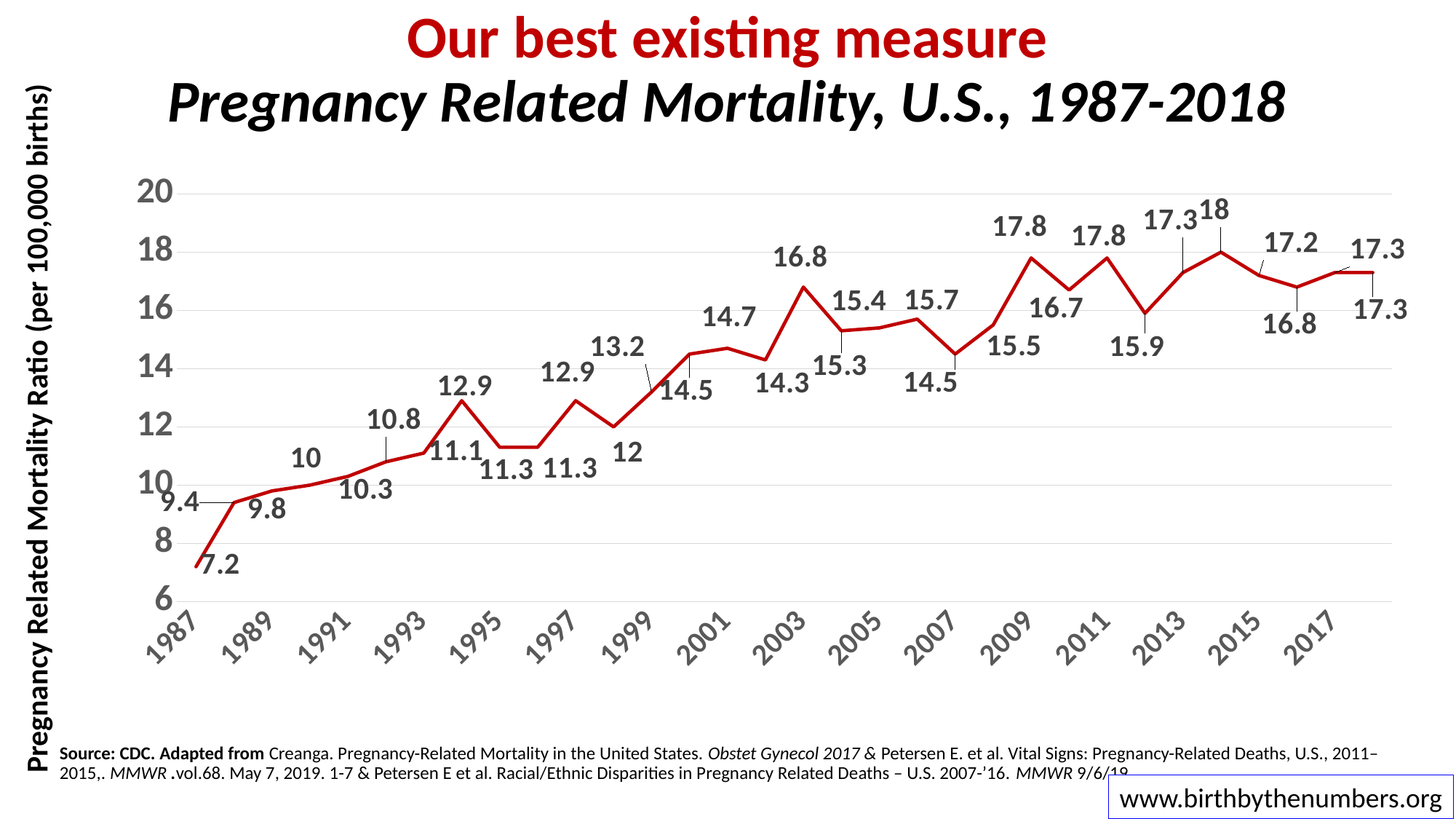
What is the pregnancy related mortality ratio for 1987? 7.2 Is the value for 2007 greater or less than 16? less What is the label on the vertical axis? Pregnancy Related Mortality Ratio (per 100,000 births) Which year has the lowest pregnancy related mortality ratio? 1987 What is the difference between the values for 2003 and 1987? 9.6 What type of chart is shown on the slide? line chart What is the pregnancy related mortality ratio for 1997? 12.9 What is the highest value plotted on the chart? 18 What is the pregnancy related mortality ratio for 2009? 17.8 Which year has the larger value, 2003 or 2005? 2003 Overall, do the values rise or fall from 1987 to 2018? rise What is the pregnancy related mortality ratio for 2003? 16.8